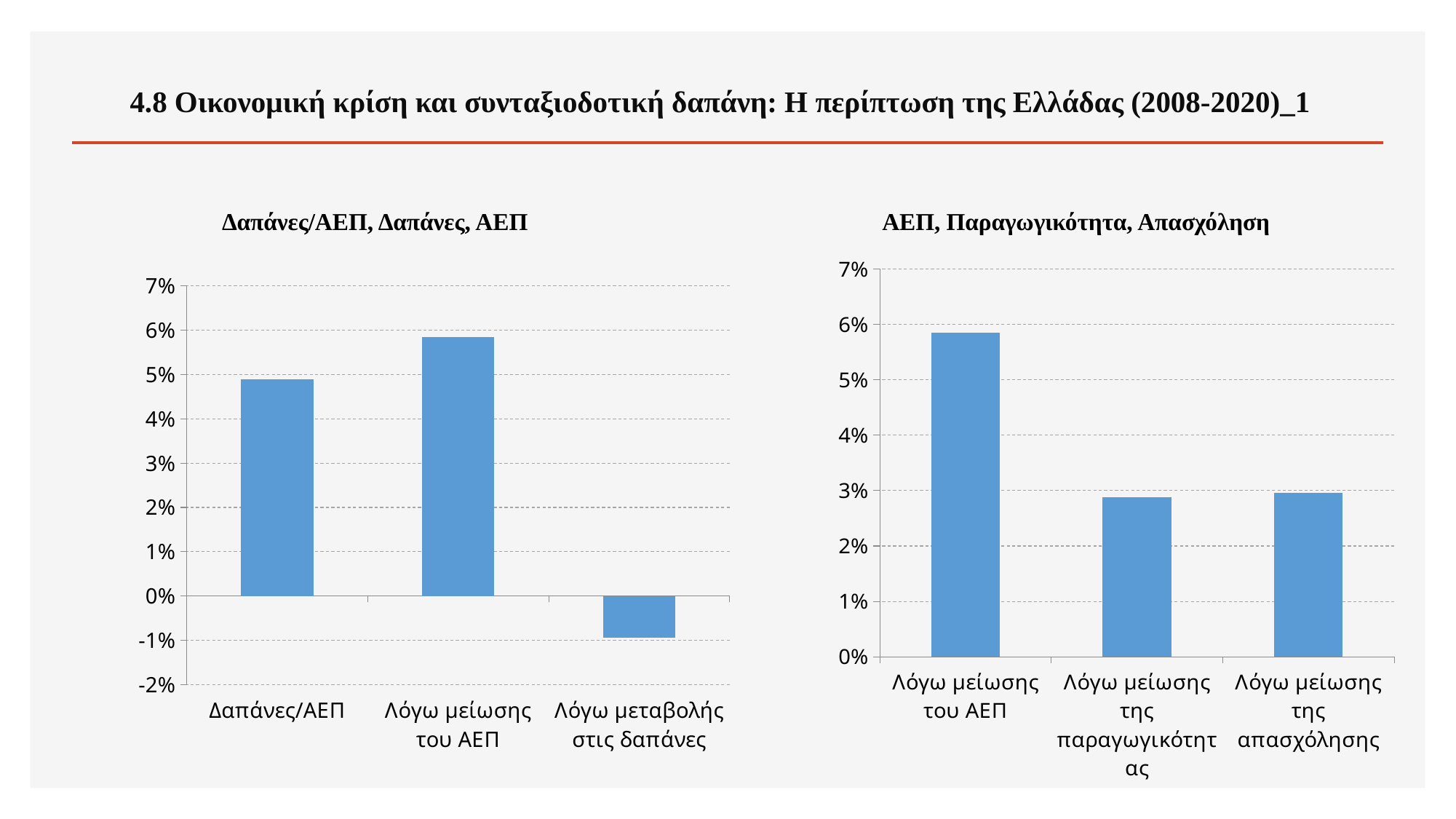
What kind of chart is the left chart titled "Δαπάνες/ΑΕΠ, Δαπάνες, ΑΕΠ"? Bar chart In the right chart "ΑΕΠ, Παραγωγικότητα, Απασχόληση", which category has the highest value? Λόγω μείωσης του ΑΕΠ In the left chart "Δαπάνες/ΑΕΠ, Δαπάνες, ΑΕΠ", is the value for Δαπάνες/ΑΕΠ greater or less than 4%? greater In the left chart "Δαπάνες/ΑΕΠ, Δαπάνες, ΑΕΠ", which is larger: Δαπάνες/ΑΕΠ or Λόγω μείωσης του ΑΕΠ? Λόγω μείωσης του ΑΕΠ In the left chart "Δαπάνες/ΑΕΠ, Δαπάνες, ΑΕΠ", is the value for Λόγω μεταβολής στις δαπάνες greater or less than 0%? less How many bars does the right chart "ΑΕΠ, Παραγωγικότητα, Απασχόληση" show? 3 In the left chart "Δαπάνες/ΑΕΠ, Δαπάνες, ΑΕΠ", which category has the lowest value? Λόγω μεταβολής στις δαπάνες In the left chart "Δαπάνες/ΑΕΠ, Δαπάνες, ΑΕΠ", which category has the highest value? Λόγω μείωσης του ΑΕΠ In the right chart "ΑΕΠ, Παραγωγικότητα, Απασχόληση", is the value for Λόγω μείωσης του ΑΕΠ greater or less than 5%? greater What is the title of the right chart? ΑΕΠ, Παραγωγικότητα, Απασχόληση How many bars does the left chart "Δαπάνες/ΑΕΠ, Δαπάνες, ΑΕΠ" show? 3